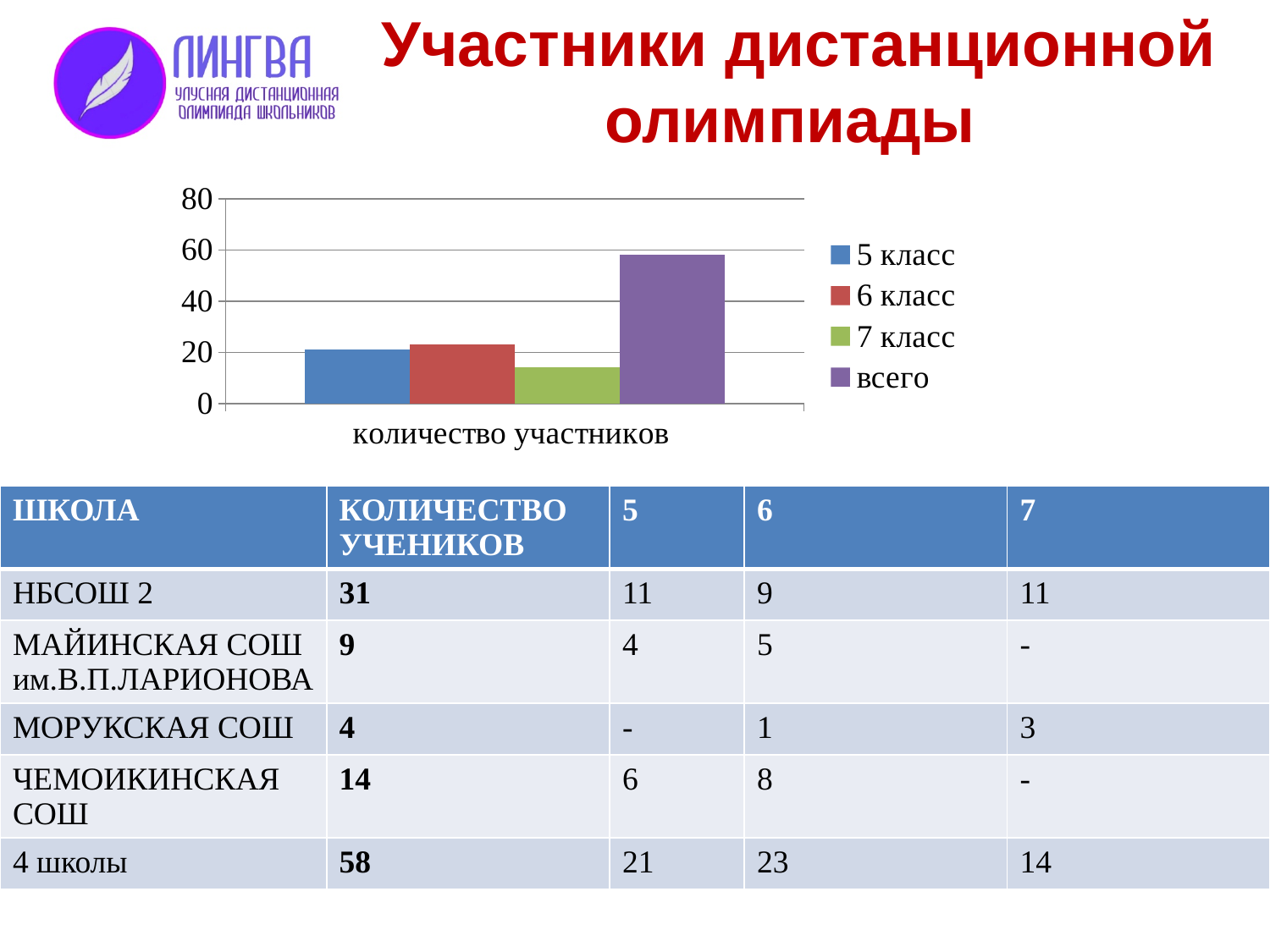
Which series has the tallest bar in the chart? всего What is the highest value shown on the chart's vertical axis? 80 Which bar is taller, всего or 5 класс? всего Is the bar for 6 класс greater or less than 40? less How many series does the chart legend list? 4 Is the bar for всего greater or less than 40? greater Which series has the shortest bar in the chart? 7 класс How many categories are shown along the x axis of the chart? 1 Is the bar for 7 класс greater or less than 20? less Which bar is taller, 6 класс or 7 класс? 6 класс What is the label shown under the x axis of the chart? количество участников What kind of chart is shown on the slide? bar chart